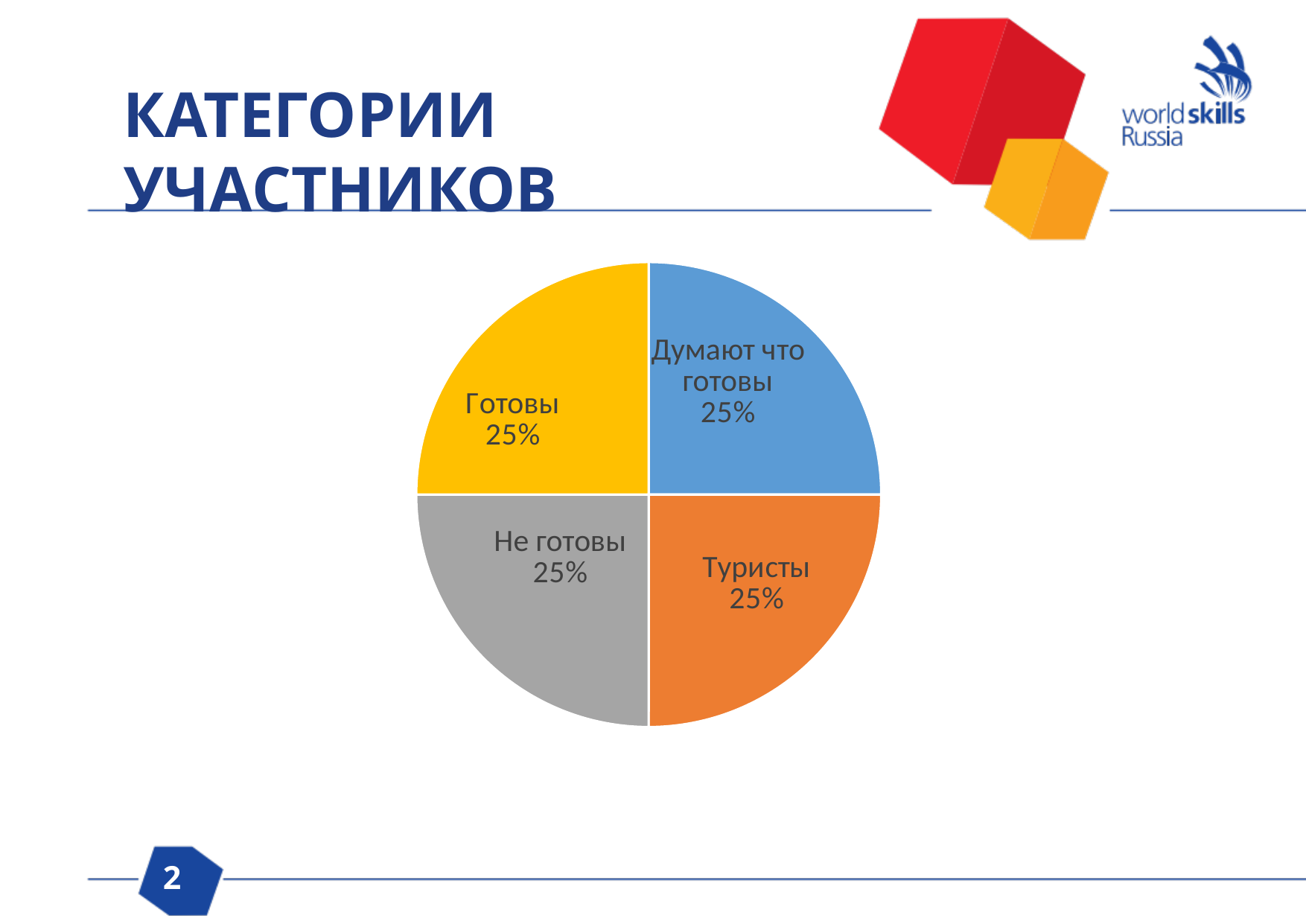
What is the difference between the values for "Готовы" and "Не готовы"? 0% Which slice of the pie chart is coloured orange? Туристы How many slices does the pie chart have? 4 What is the value shown for "Думают что готовы"? 25% What kind of chart is shown on the slide? pie chart What is the value shown for "Готовы"? 25% Which slice of the pie chart is coloured grey? Не готовы What is the value shown for "Не готовы"? 25% What share of the pie does the "Туристы" slice represent? 25% What is the combined share of the "Готовы" and "Думают что готовы" slices? 50%